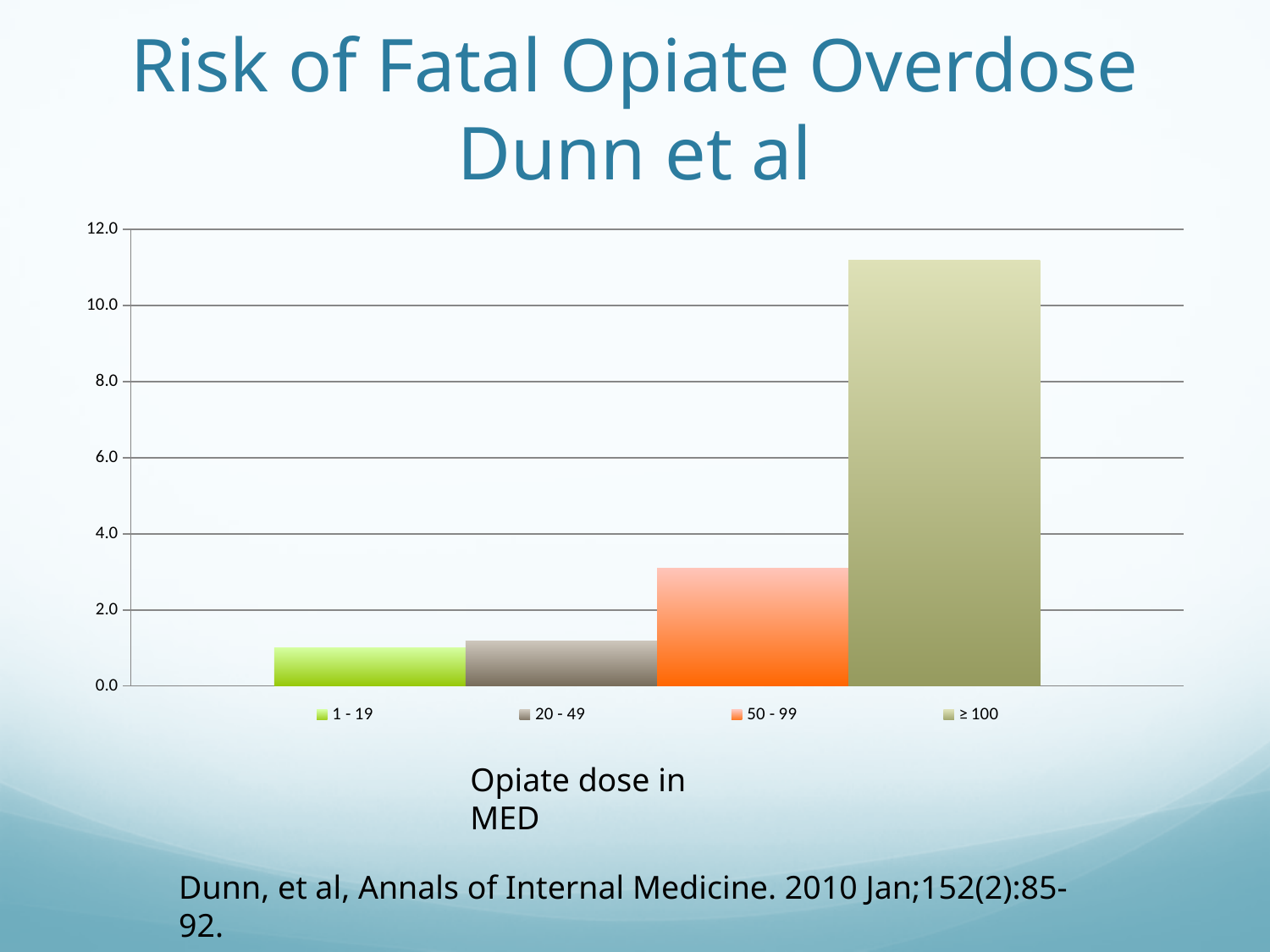
Is the value for the 50 - 99 category greater or less than 2.0? greater What label is given for the x axis below the legend? Opiate dose in MED Is the value for the ≥ 100 category greater or less than 10.0? greater What kind of chart is shown on the slide? bar chart Which is larger, the value for 50 - 99 or the value for 20 - 49? 50 - 99 Do the values rise or fall as the opiate dose category increases along the x axis? rise Which dose category has the highest risk of fatal opiate overdose? ≥ 100 What is the title of the chart on the slide? Risk of Fatal Opiate Overdose Dunn et al How many bars are plotted in the chart? 4 Is the value for the 1 - 19 category greater or less than 2.0? less How many entries does the legend list? 4